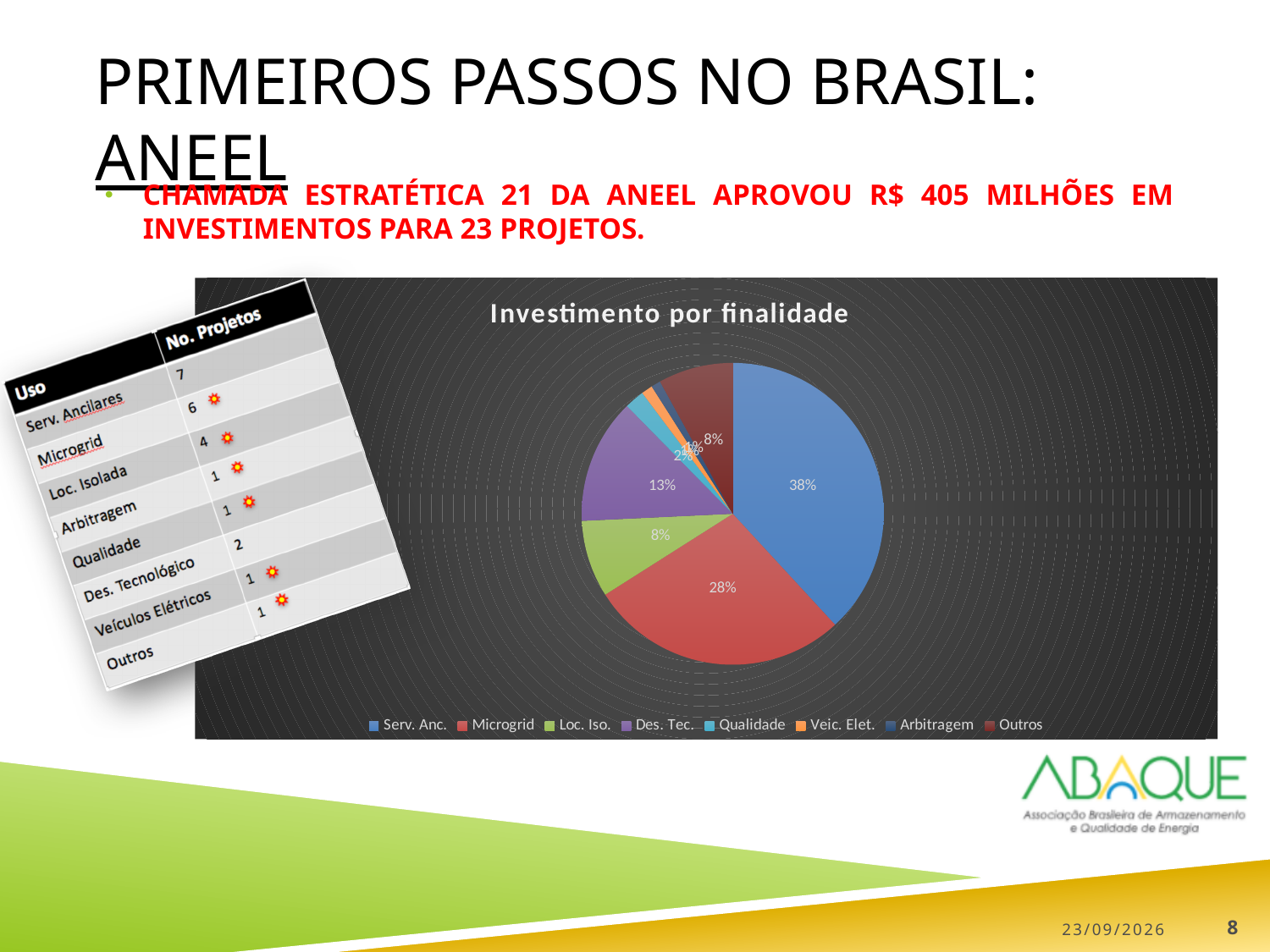
What kind of chart is shown on the slide? pie chart What share of the pie does Serv. Anc. represent? 38% What is the value shown for Des. Tec.? 13% What is the value shown for Loc. Iso.? 8% What is the value shown for Microgrid? 28% What is the value shown for Outros? 8% How many entries does the chart's legend list? 8 Which category has the largest slice of the pie? Serv. Anc. Which is larger, the slice for Des. Tec. or the slice for Loc. Iso.? Des. Tec. How many slices does the pie chart have? 8 What is the title of the chart? Investimento por finalidade What is the difference in percentage points between Serv. Anc. and Microgrid? 10